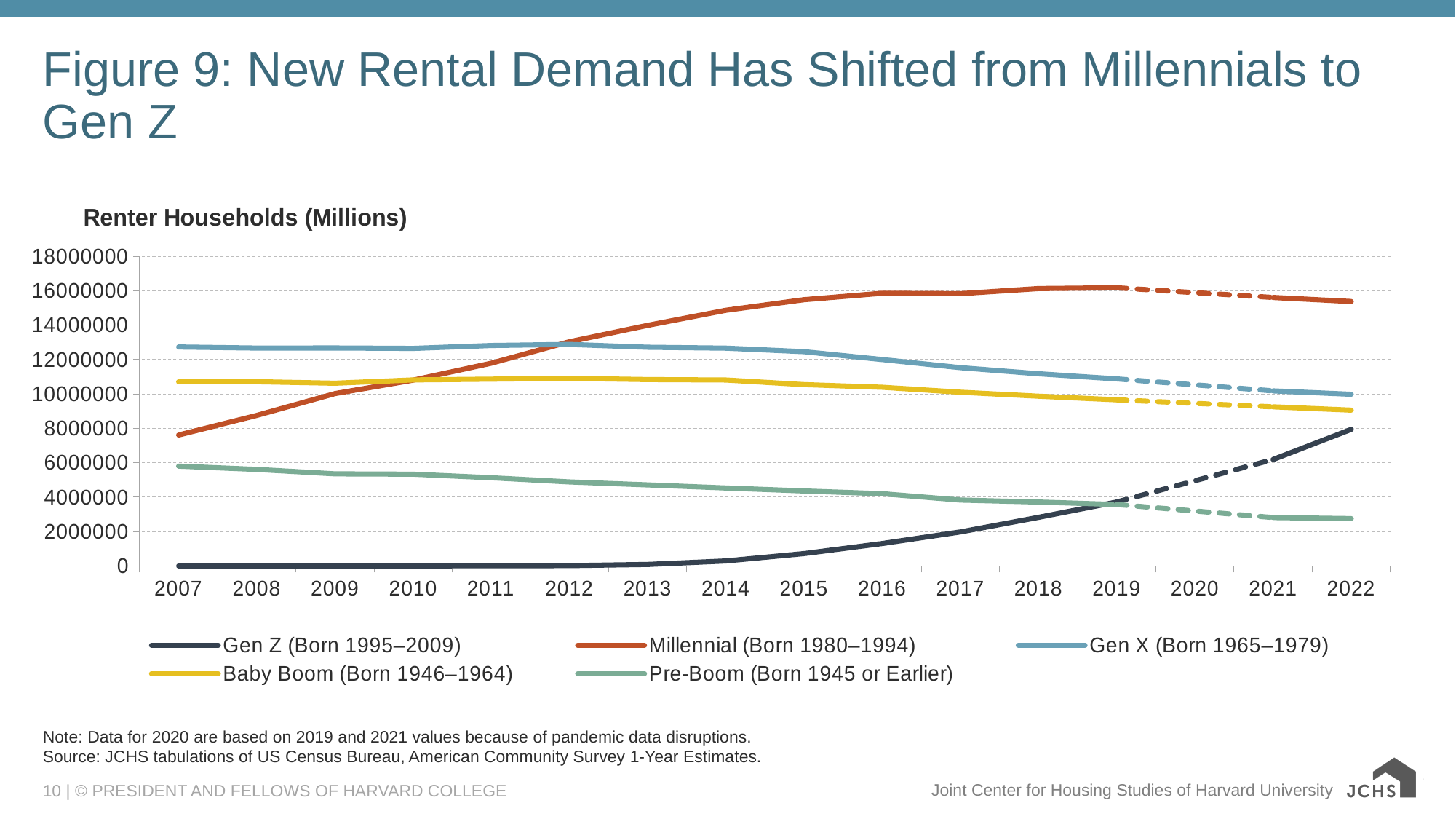
Is the value for Pre-Boom in 2022 greater or less than 4000000? less How many series does the legend list? 5 Is the value for Gen Z in 2022 greater or less than 6000000? greater In 2007, which is larger: Millennial or Gen X? Gen X What kind of chart is shown on the slide? line chart Which generation has the lowest number of renter households in 2007? Gen Z (Born 1995–2009) Does the Pre-Boom line rise or fall from 2007 to 2022? fall What is the axis title shown above the chart? Renter Households (Millions) Which generation has the highest number of renter households in 2022? Millennial (Born 1980–1994) How many years are shown along the x axis? 16 Does the Gen Z line rise or fall from 2007 to 2022? rise Is the value for Millennial in 2016 greater or less than 14000000? greater